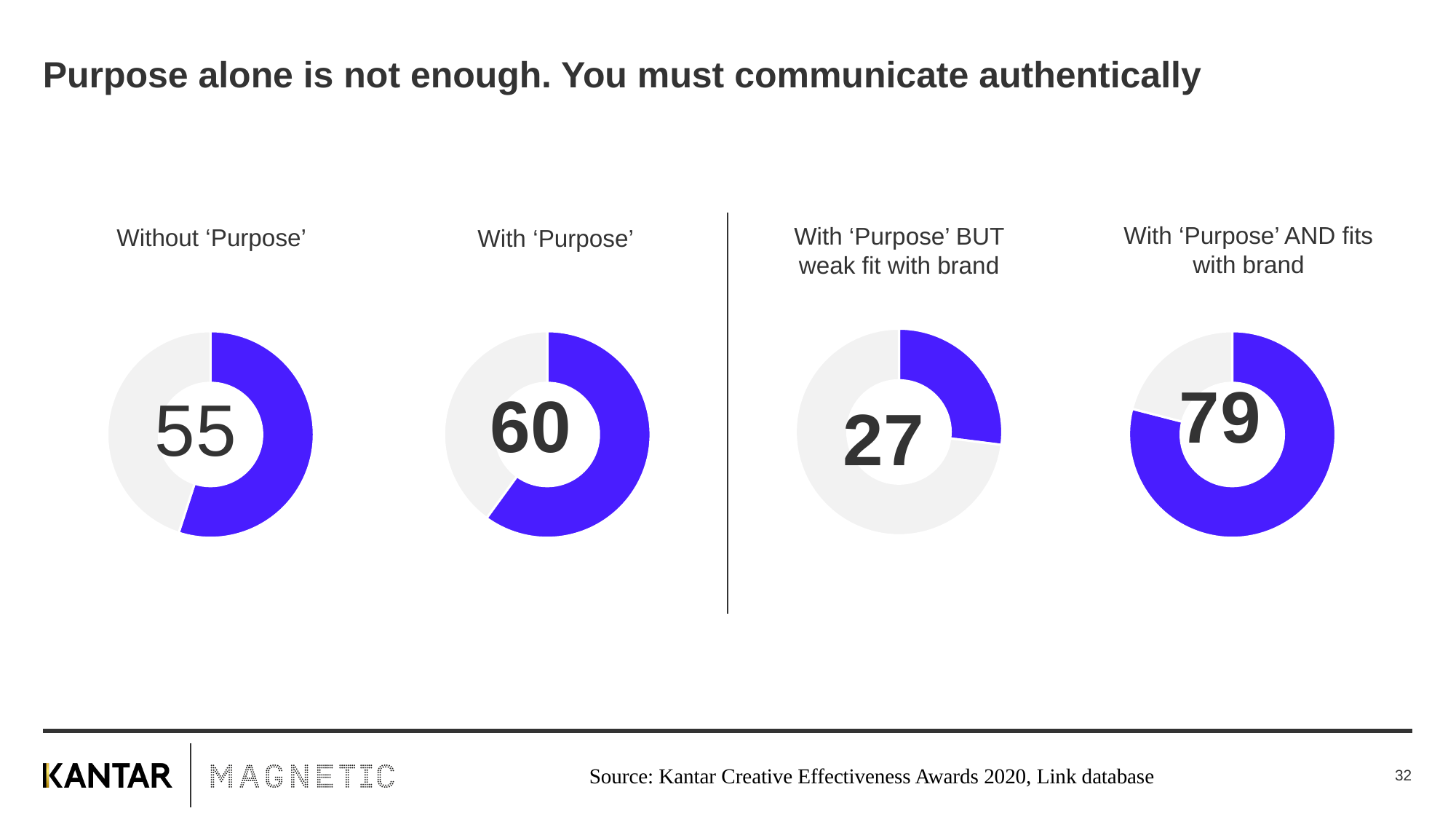
What colour is the filled portion of each donut chart? Purple In the 'With ‘Purpose’' chart, what value is shown in the centre of the donut? 60 What kind of chart is used to display the values on the slide? Donut chart What is the difference between the value in the 'With ‘Purpose’' chart and the value in the 'Without ‘Purpose’' chart? 5 Which is larger: the value in the 'With ‘Purpose’' chart or the value in the 'Without ‘Purpose’' chart? With ‘Purpose’ In the 'With ‘Purpose’ BUT weak fit with brand' chart, what value is shown? 27 Across the four donut charts on the slide, which one shows the lowest value? With ‘Purpose’ BUT weak fit with brand Across the four donut charts on the slide, which one shows the highest value? With ‘Purpose’ AND fits with brand How many donut charts are shown on the slide? 4 What is the difference between the value in the 'With ‘Purpose’ AND fits with brand' chart and the value in the 'With ‘Purpose’ BUT weak fit with brand' chart? 52 In the 'With ‘Purpose’ AND fits with brand' chart, what value is shown? 79 In the 'Without ‘Purpose’' chart, what value is shown in the centre of the donut? 55